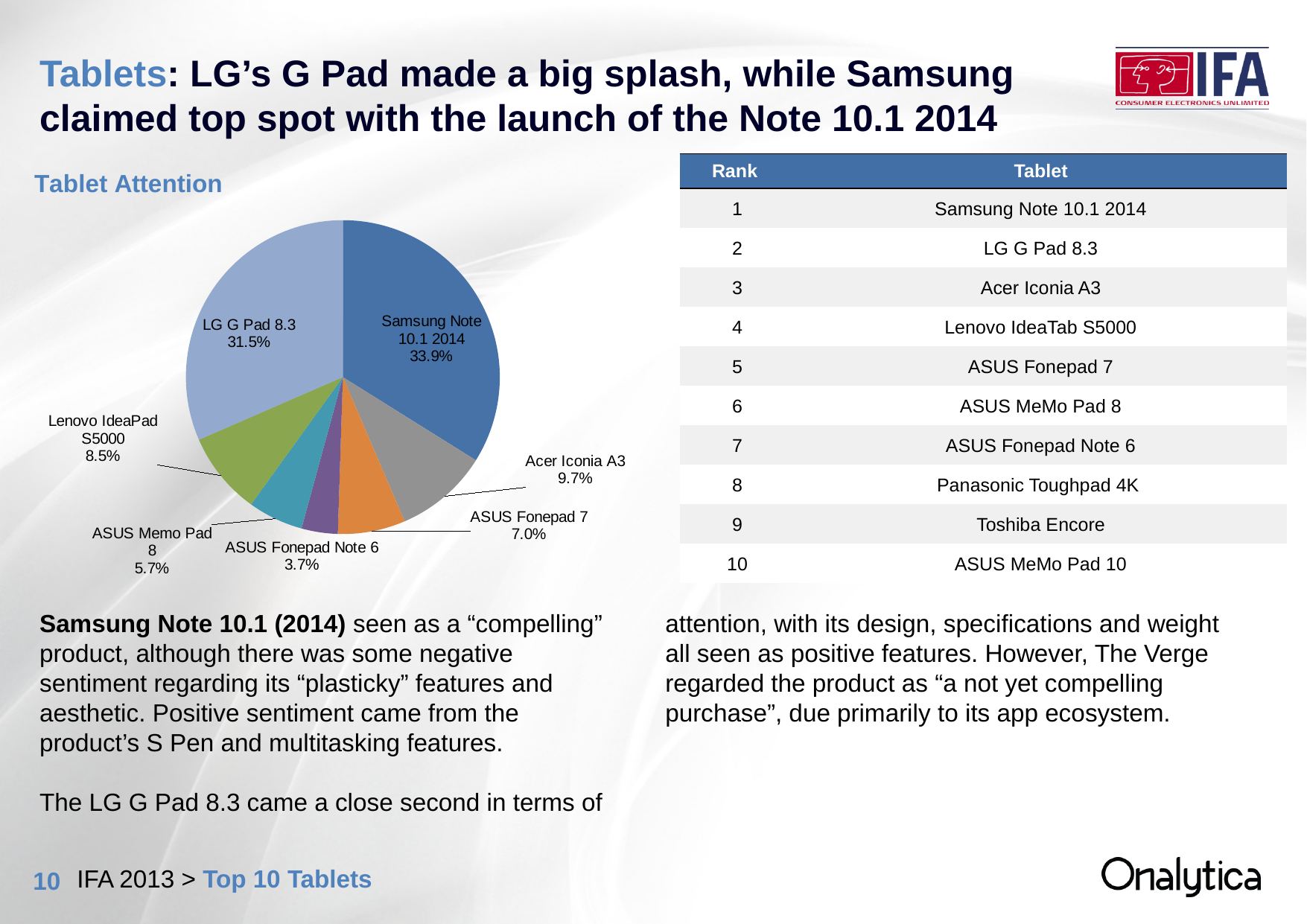
What percentage is shown for the Lenovo IdeaPad S5000 in the pie chart? 8.5% What is the title of the pie chart on the slide? Tablet Attention What share of tablet attention does the LG G Pad 8.3 have in the pie chart? 31.5% How many percentage points larger is the Samsung Note 10.1 2014 slice than the LG G Pad 8.3 slice? 2.4 What share of tablet attention does the Samsung Note 10.1 2014 have in the pie chart? 33.9% Which has a larger share in the pie chart, the ASUS Fonepad 7 or the ASUS Memo Pad 8? ASUS Fonepad 7 Which tablet has the largest slice in the Tablet Attention pie chart? Samsung Note 10.1 2014 Which tablet has the smallest slice in the Tablet Attention pie chart? ASUS Fonepad Note 6 How many tablets are shown as slices in the Tablet Attention pie chart? 7 What kind of chart is shown under the heading "Tablet Attention"? Pie chart What percentage is shown for the ASUS Fonepad Note 6 in the pie chart? 3.7% What percentage is shown for the Acer Iconia A3 in the pie chart? 9.7%